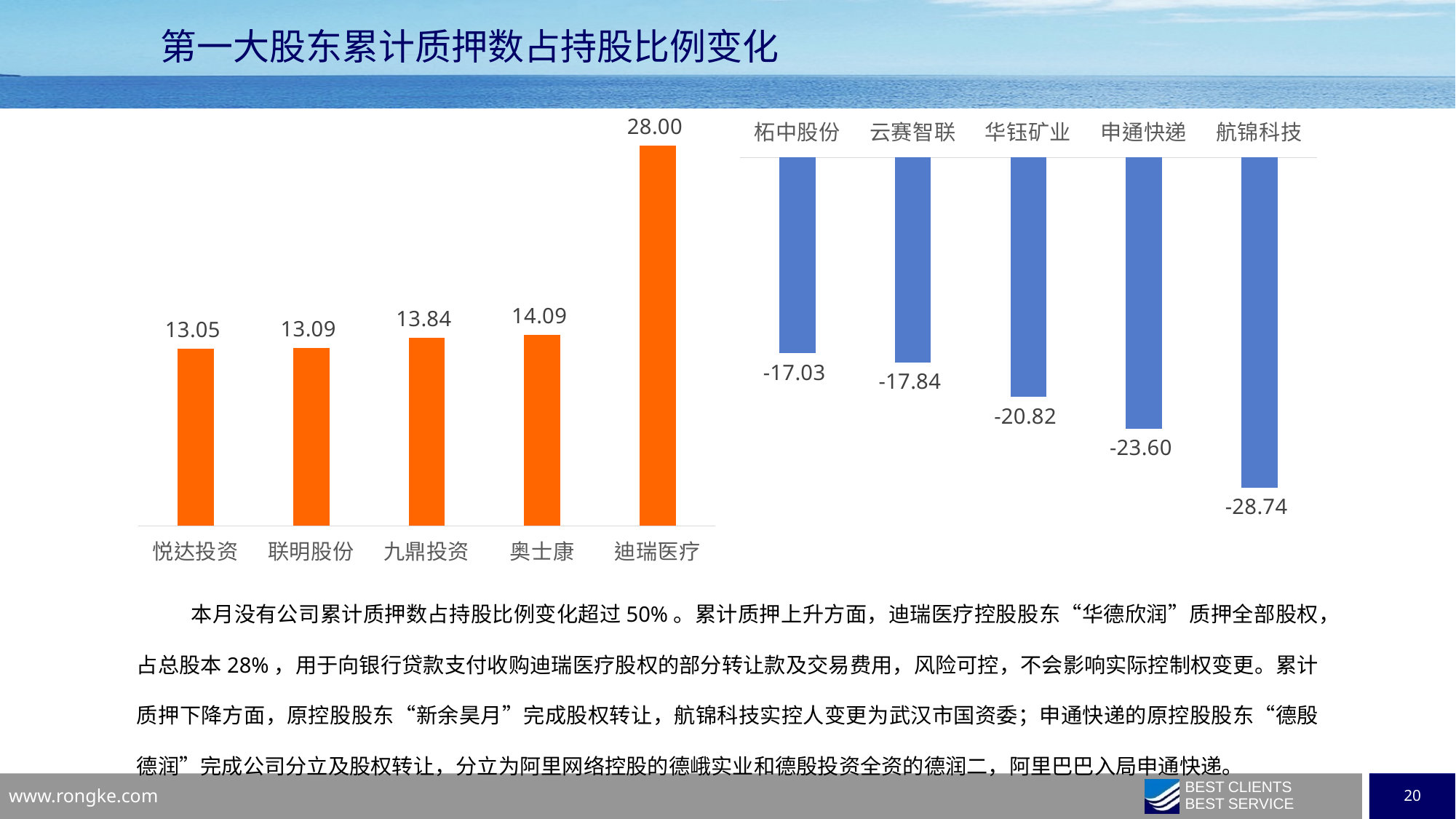
In the right chart (blue bars), which category has the lowest value? 航锦科技 What kind of chart is the left chart on the slide? Bar chart In the right chart (blue bars), what is the value for 申通快递? -23.60 In the left chart (orange bars), what is the value for 迪瑞医疗? 28.00 How many categories are shown in the right chart (blue bars)? 5 What is the title of the slide? 第一大股东累计质押数占持股比例变化 In the left chart (orange bars), what is the difference between the values for 迪瑞医疗 and 奥士康? 13.91 In the left chart (orange bars), which category has the highest value? 迪瑞医疗 In the right chart (blue bars), what is the difference between the values for 云赛智联 and 华钰矿业? 2.98 In the left chart (orange bars), what is the value for 九鼎投资? 13.84 In the right chart (blue bars), what is the value for 柘中股份? -17.03 In the left chart (orange bars), which is larger, the value for 奥士康 or the value for 悦达投资? 奥士康